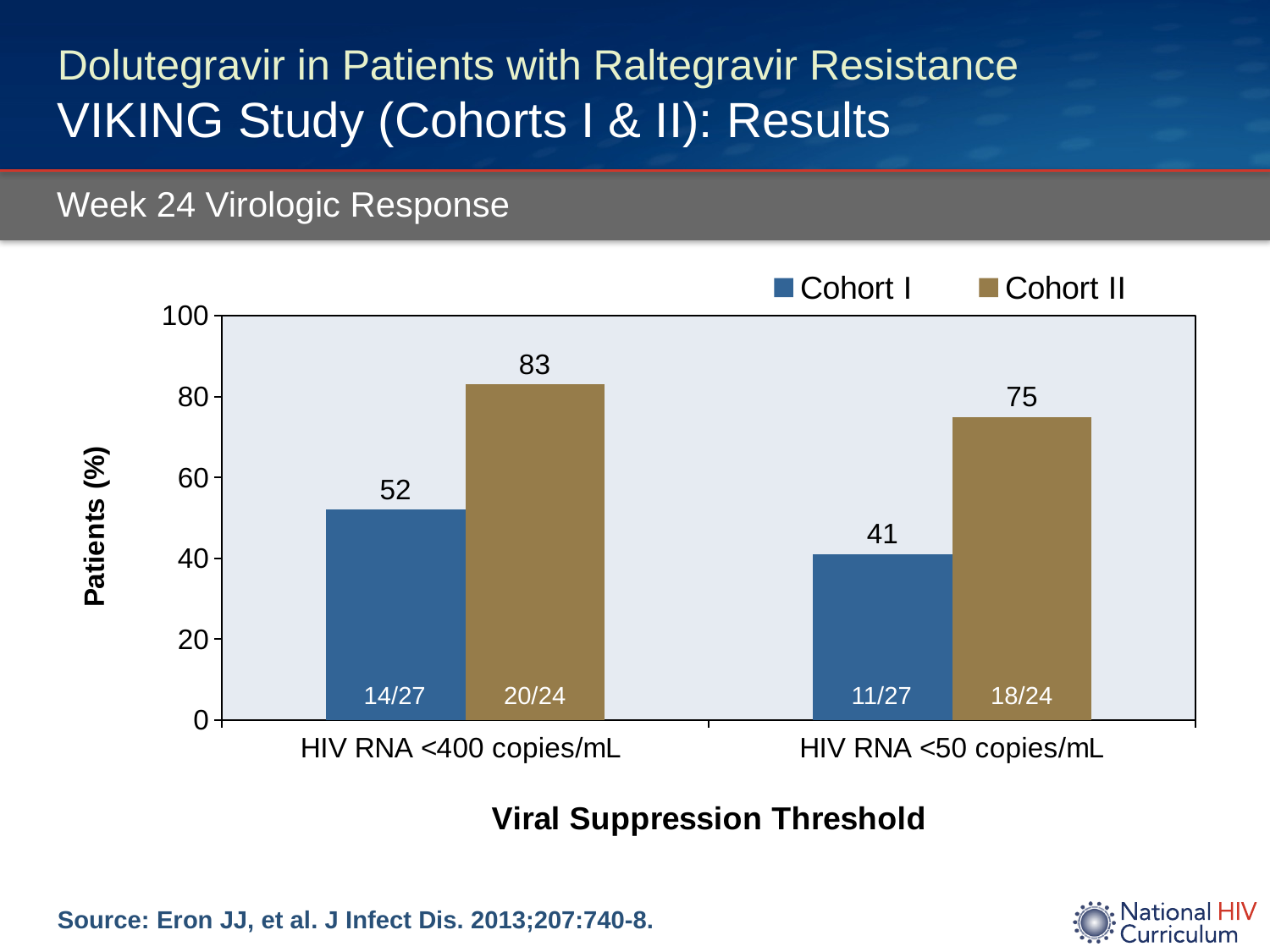
What is the value for Cohort II at HIV RNA <400 copies/mL? 83 What is the value for Cohort I at HIV RNA <400 copies/mL? 52 What is the value for Cohort II at HIV RNA <50 copies/mL? 75 Which bar has the highest value on the chart? Cohort II at HIV RNA <400 copies/mL What is the difference between Cohort II and Cohort I at HIV RNA <400 copies/mL? 31 Which is larger: Cohort I at HIV RNA <400 copies/mL or Cohort I at HIV RNA <50 copies/mL? Cohort I at HIV RNA <400 copies/mL How many series does the legend list? 2 What is the difference between Cohort II and Cohort I at HIV RNA <50 copies/mL? 34 What is the label of the x axis? Viral Suppression Threshold What kind of chart is shown on the slide? Bar chart What fraction of patients is shown inside the Cohort I bar for HIV RNA <50 copies/mL? 11/27 Which bar has the lowest value on the chart? Cohort I at HIV RNA <50 copies/mL